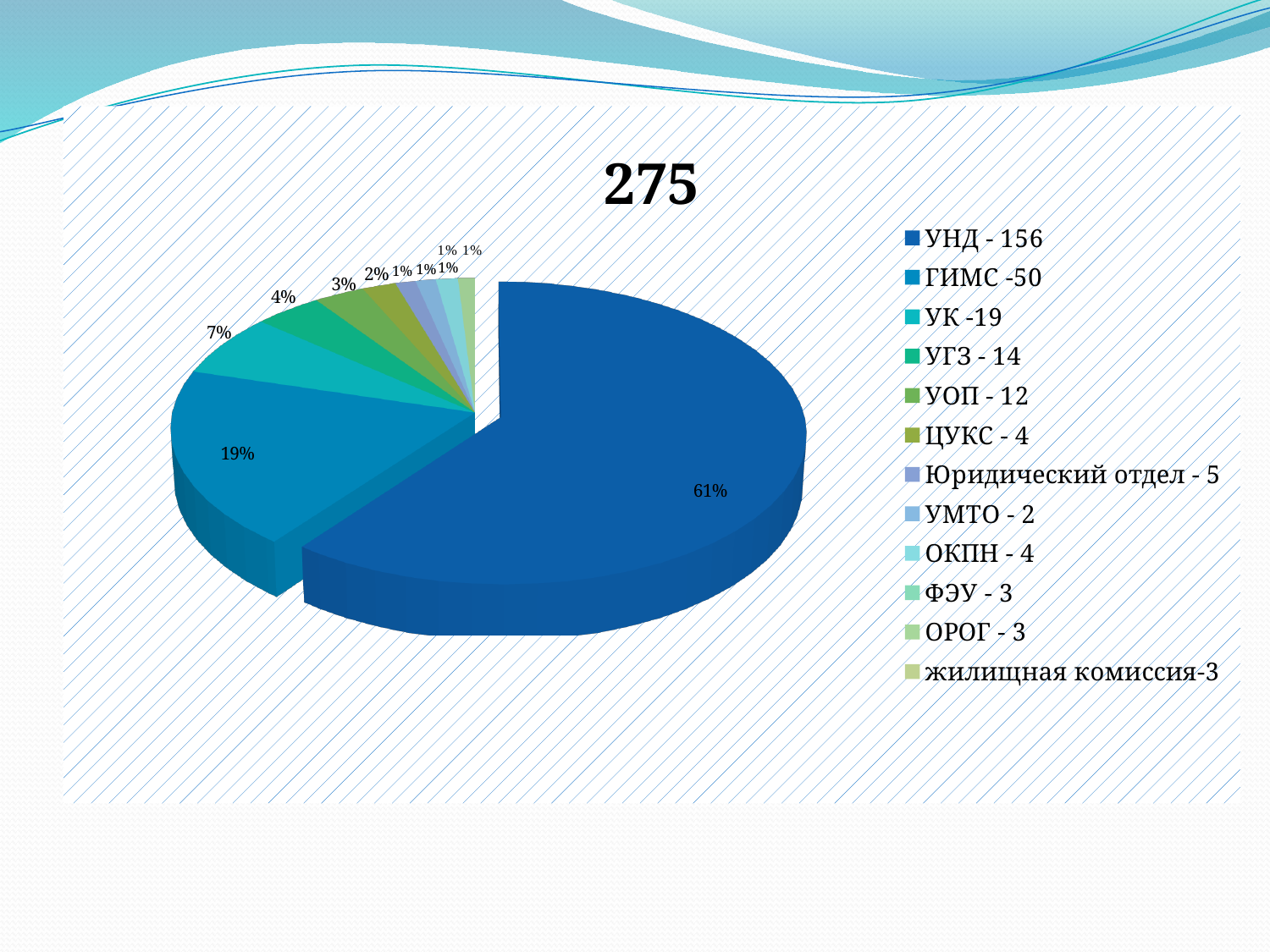
According to the legend values, what is the difference between УНД and ГИМС? 106 According to the legend, what is the value for Юридический отдел? 5 What share of the pie does the УК slice take? 7% What is the title of the chart? 275 What share of the pie does the УНД slice take? 61% How many entries does the chart legend list? 12 According to the legend, what is the value for УГЗ? 14 According to the legend, which category has the smallest value? УМТО What kind of chart is shown on the slide? pie chart Which is larger, the slice for УНД or the slice for ГИМС? УНД What share of the pie does the ГИМС slice take? 19% Which category has the largest slice of the pie? УНД